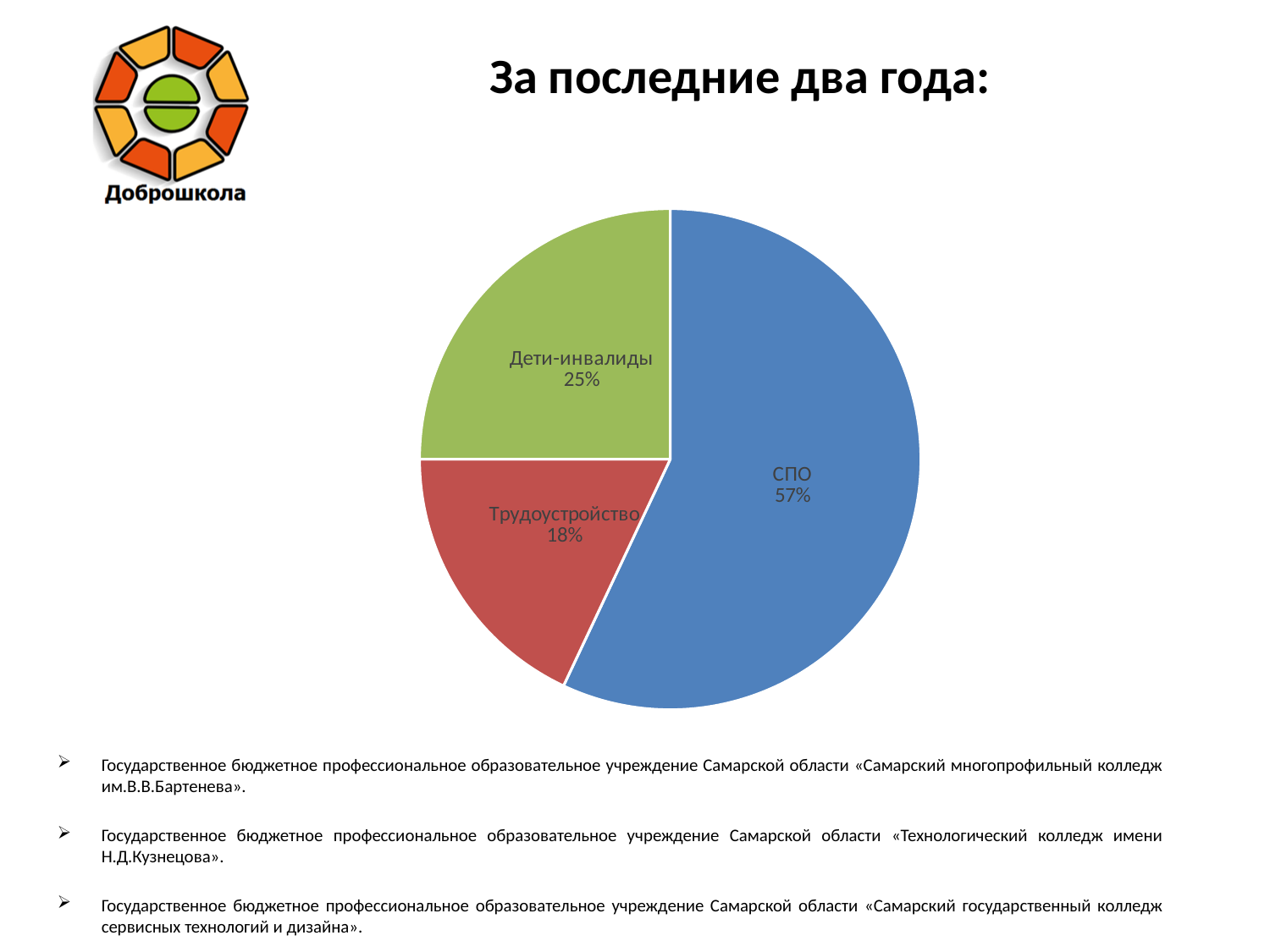
What share of the pie does Трудоустройство take? 18% What kind of chart is shown on the slide? pie chart What is the difference in percentage points between СПО and Дети-инвалиды? 32 How many slices does the pie chart have? 3 Which is larger, the share for Дети-инвалиды or the share for Трудоустройство? Дети-инвалиды What share of the pie does Дети-инвалиды take? 25% What is the title shown above the chart? За последние два года: What colour is the СПО slice? blue Which slice of the pie is the largest? СПО Which slice of the pie is the smallest? Трудоустройство What is the difference in percentage points between Дети-инвалиды and Трудоустройство? 7 What share of the pie does СПО take? 57%